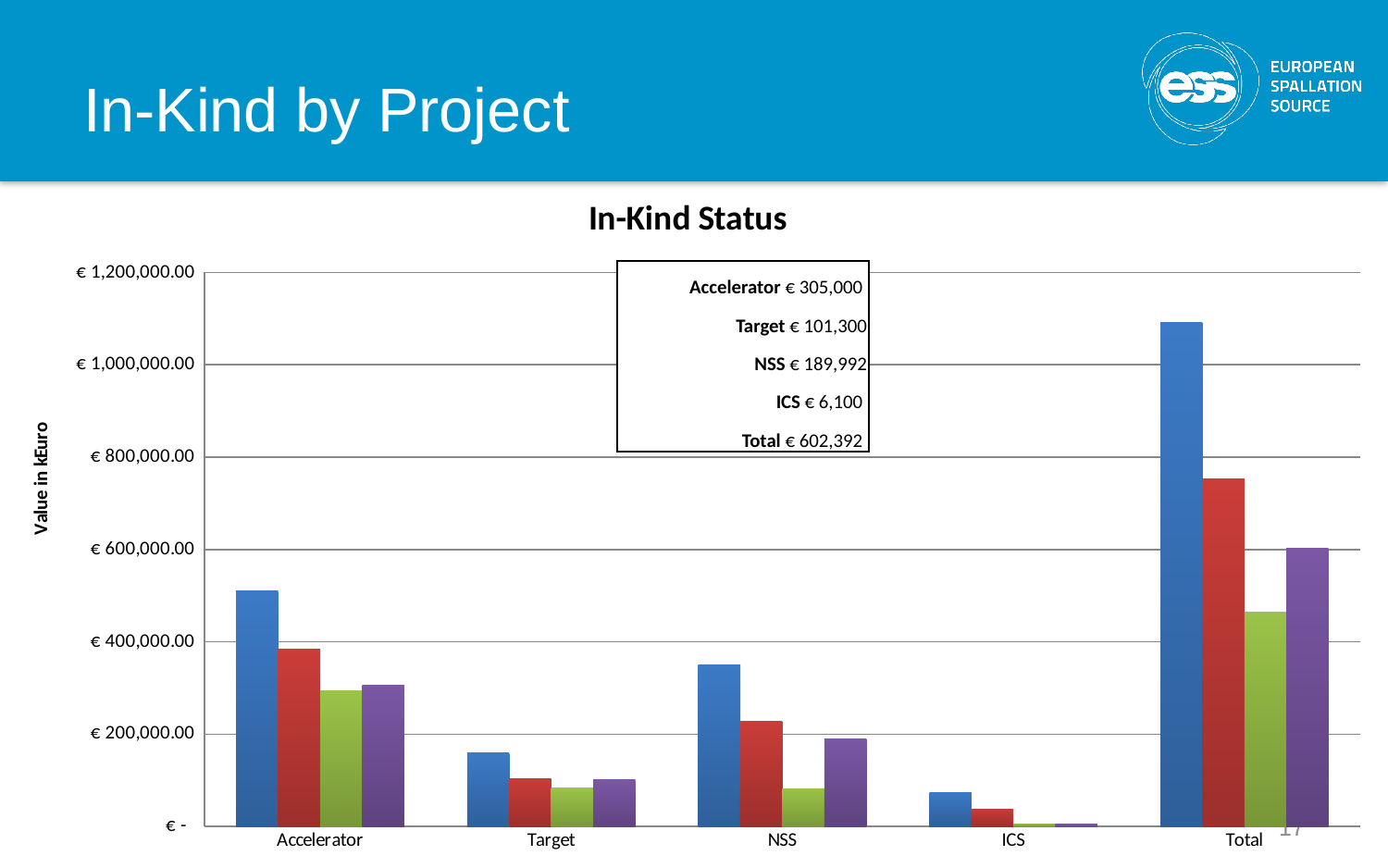
Is the blue bar for Total greater or less than 1,000,000? greater Which category has the tallest bar in the In-Kind Status chart? Total Is the red bar for Total greater or less than 800,000? less Is the green bar for Total greater or less than 400,000? greater Which category has the shortest bars in the In-Kind Status chart? ICS What value does the text box on the chart list for Total? € 602,392 What value does the text box on the chart list for NSS? € 189,992 Which has the taller blue bar, Accelerator or NSS? Accelerator What is the title of the chart? In-Kind Status What kind of chart is shown on the slide? bar chart How many categories are shown on the x axis of the In-Kind Status chart? 5